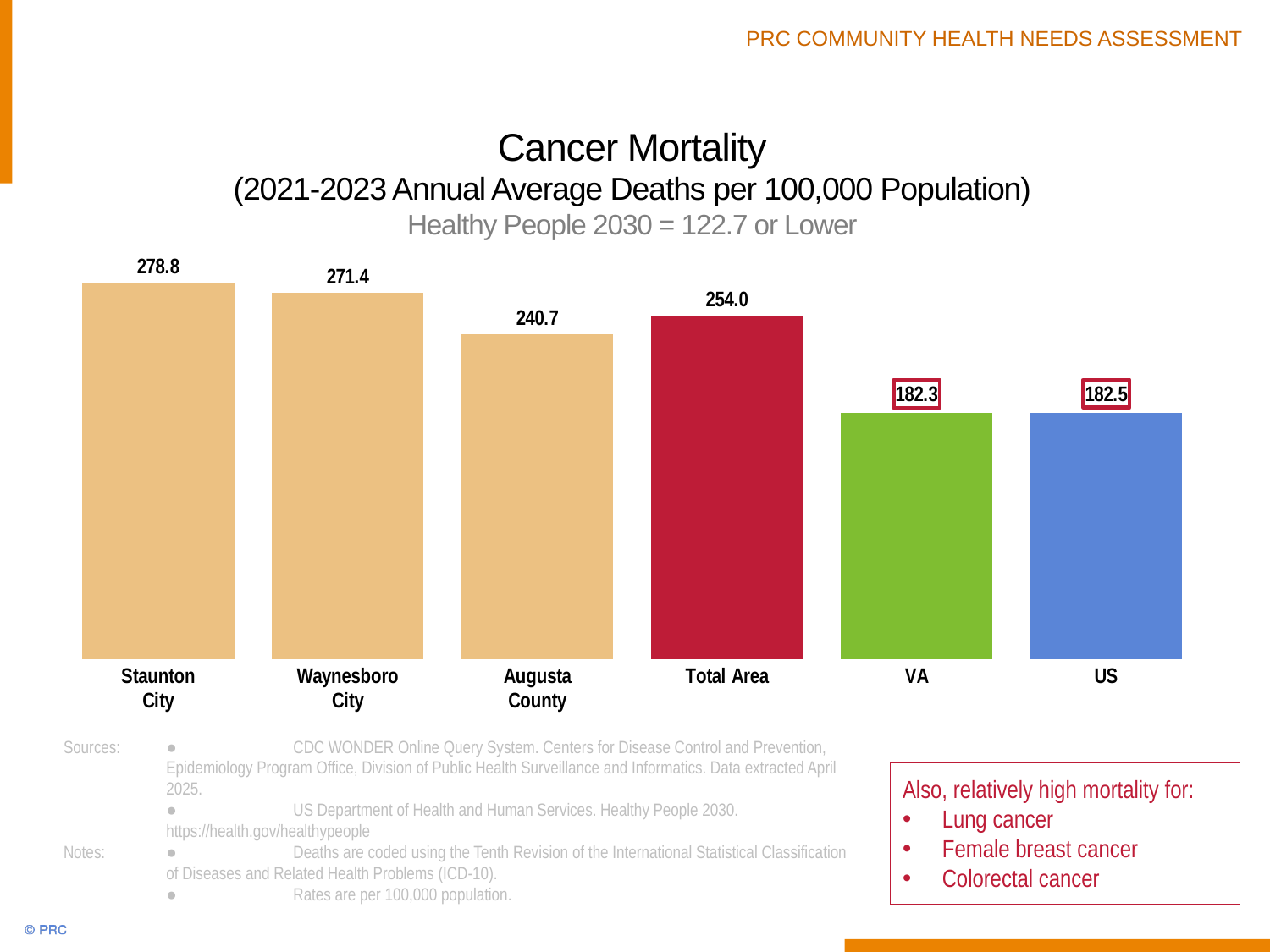
What is the difference between the cancer mortality rates for Staunton City and Waynesboro City? 7.4 What is the cancer mortality rate for Staunton City? 278.8 What is the cancer mortality rate for the Total Area? 254.0 What is the Healthy People 2030 target stated in the chart subtitle? 122.7 or Lower What is the difference between the cancer mortality rates for the Total Area and the US? 71.5 Which has a higher cancer mortality rate, Waynesboro City or Augusta County? Waynesboro City Which category has the lowest cancer mortality rate? VA What kind of chart is shown on the slide? Bar chart How many categories are shown in the chart? 6 What is the cancer mortality rate for VA? 182.3 What is the cancer mortality rate for Augusta County? 240.7 Which category has the highest cancer mortality rate? Staunton City